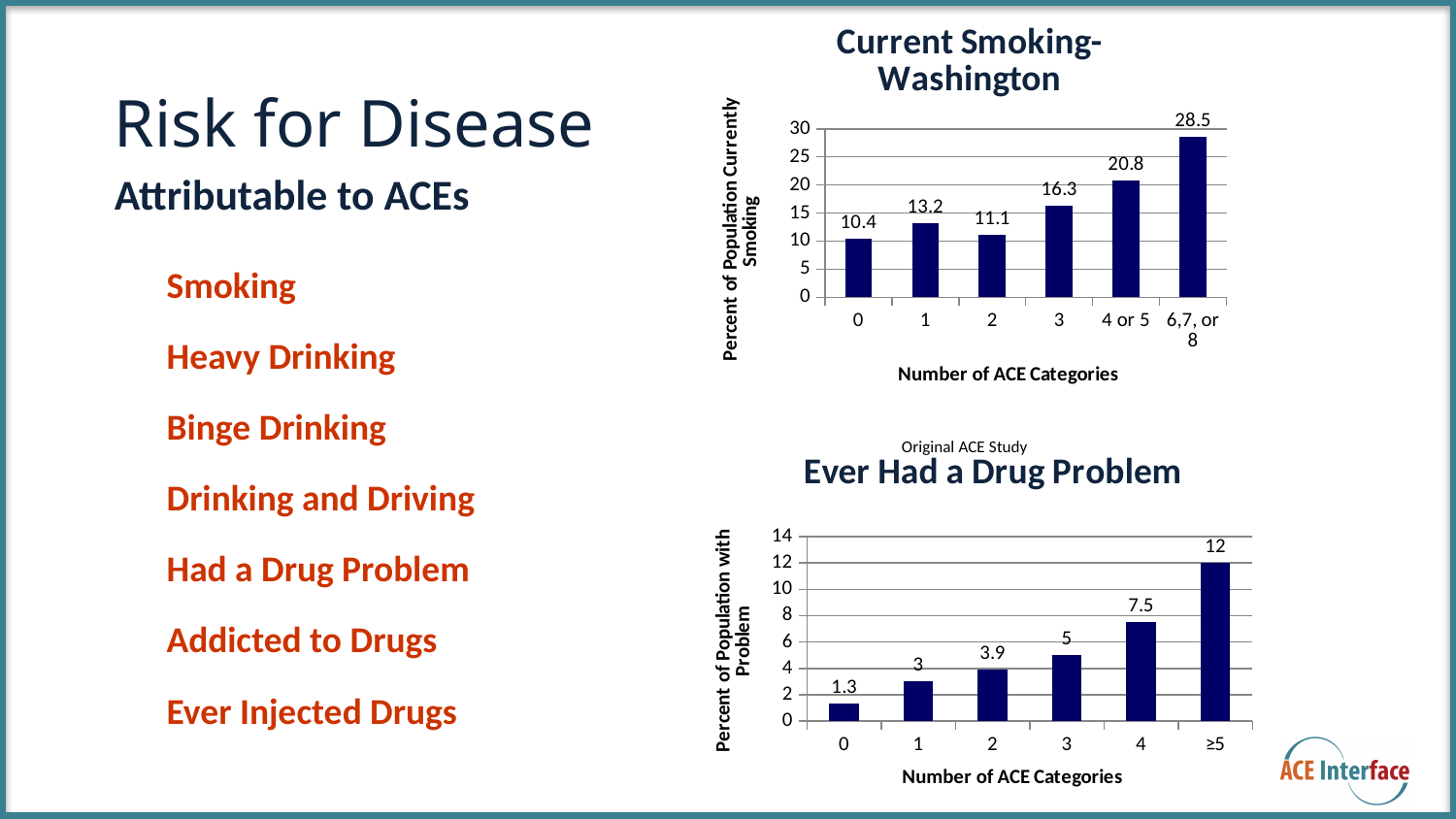
In the 'Current Smoking- Washington' chart, what is the difference between the values for '6,7, or 8' and '0' ACE categories? 18.1 What is the x-axis title of the 'Ever Had a Drug Problem' chart? Number of ACE Categories In the 'Current Smoking- Washington' chart, which is larger: the value for 1 ACE category or for 2 ACE categories? 1 In the 'Ever Had a Drug Problem' chart, what is the value for 4 ACE categories? 7.5 In the 'Current Smoking- Washington' chart, what is the value for 3 ACE categories? 16.3 In the 'Ever Had a Drug Problem' chart, what is the value for ≥5 ACE categories? 12 In the 'Ever Had a Drug Problem' chart, what is the difference between the values for 3 and 1 ACE categories? 2 In the 'Ever Had a Drug Problem' chart, do the values rise or fall as the number of ACE categories increases? rise In the 'Current Smoking- Washington' chart, which ACE category has the lowest value? 0 How many bars are in the 'Current Smoking- Washington' chart? 6 What kind of chart is the 'Ever Had a Drug Problem' chart? bar chart In the 'Current Smoking- Washington' chart, which ACE category has the highest percent of population currently smoking? 6,7, or 8